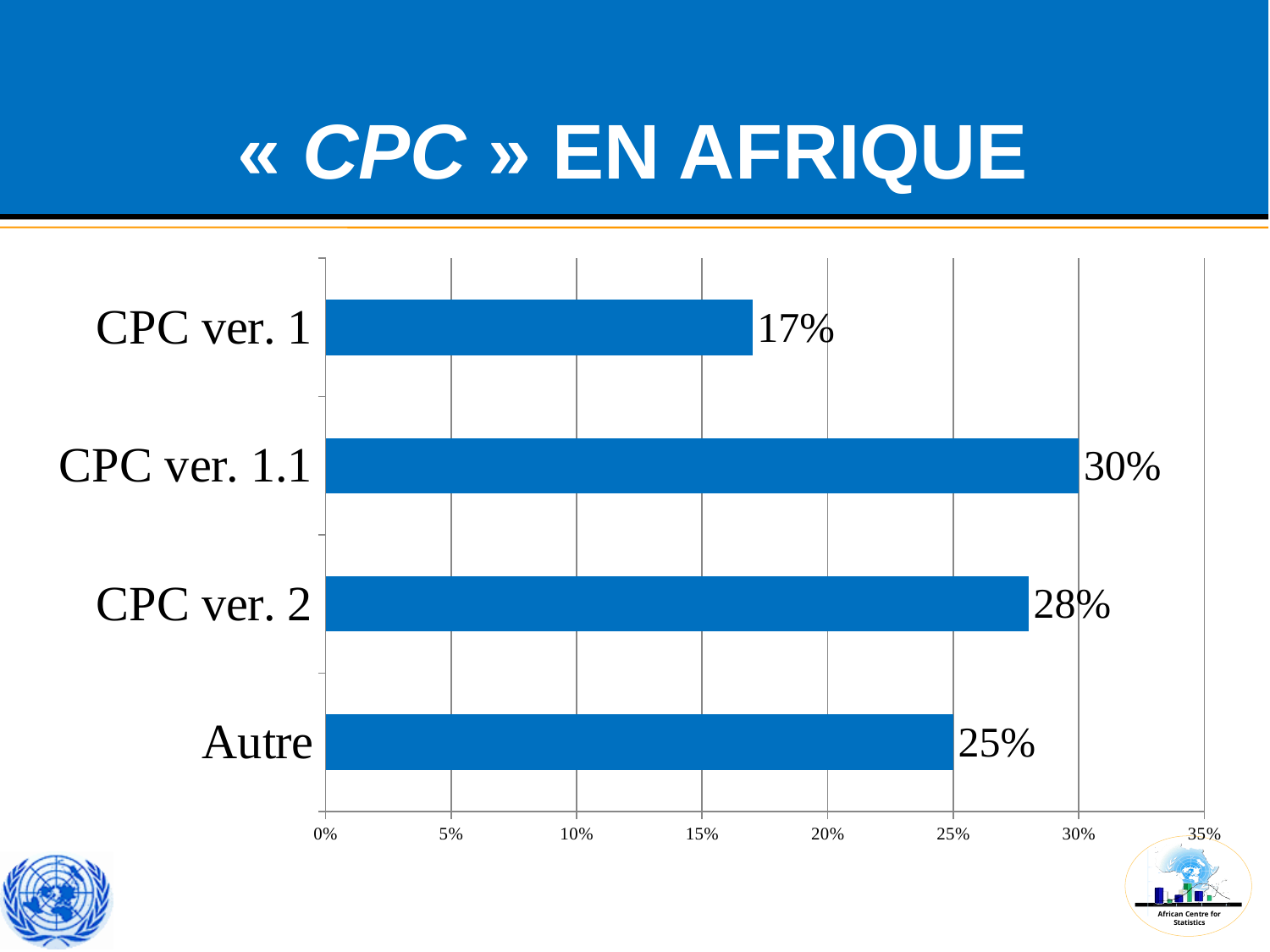
What is the value for CPC ver. 2? 28% What is the value for CPC ver. 1.1? 30% What is the difference between the values for CPC ver. 2 and Autre? 3% What is the title of the slide? « CPC » EN AFRIQUE Which category has the highest value? CPC ver. 1.1 Which category has the lowest value? CPC ver. 1 What is the value for CPC ver. 1? 17% Which is larger, the value for CPC ver. 2 or the value for Autre? CPC ver. 2 How many categories are shown in the chart? 4 What kind of chart is shown on the slide? Bar chart What is the value for Autre? 25% What is the difference between the values for CPC ver. 1.1 and CPC ver. 1? 13%